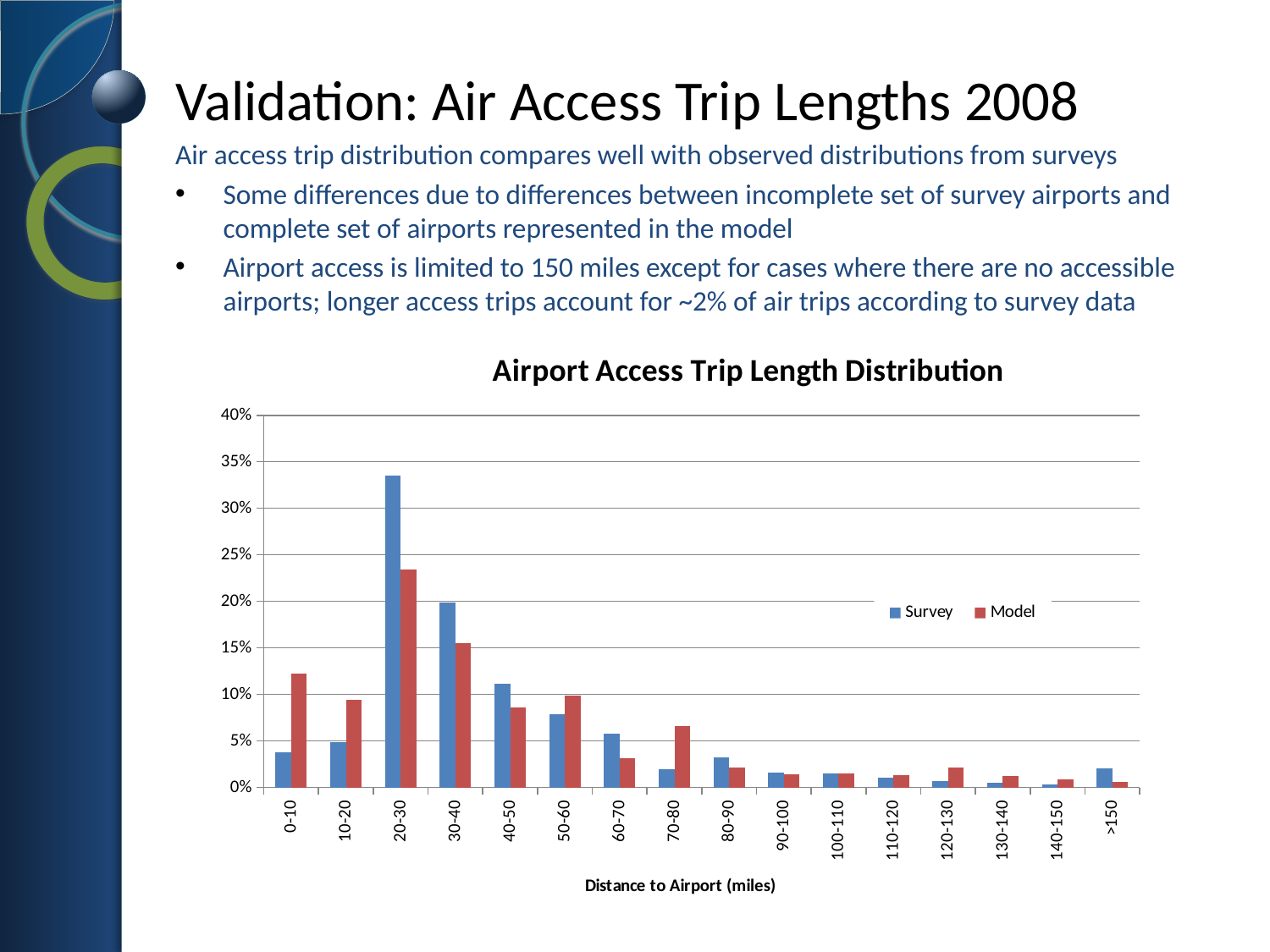
Which distance category has the highest Survey value? 20-30 For the 0-10 mile category, which series has the larger value, Survey or Model? Model What kind of chart is shown on the slide? bar chart How many distance categories are shown on the x axis? 16 How many series does the chart legend list? 2 Is the Model value for 20-30 miles greater or less than 25%? less Is the Model value for 0-10 miles greater or less than 10%? greater Is the Survey value for 20-30 miles greater or less than 30%? greater What is the title of the chart? Airport Access Trip Length Distribution For the 30-40 mile category, which series has the larger value, Survey or Model? Survey Which distance category has the highest Model value? 20-30